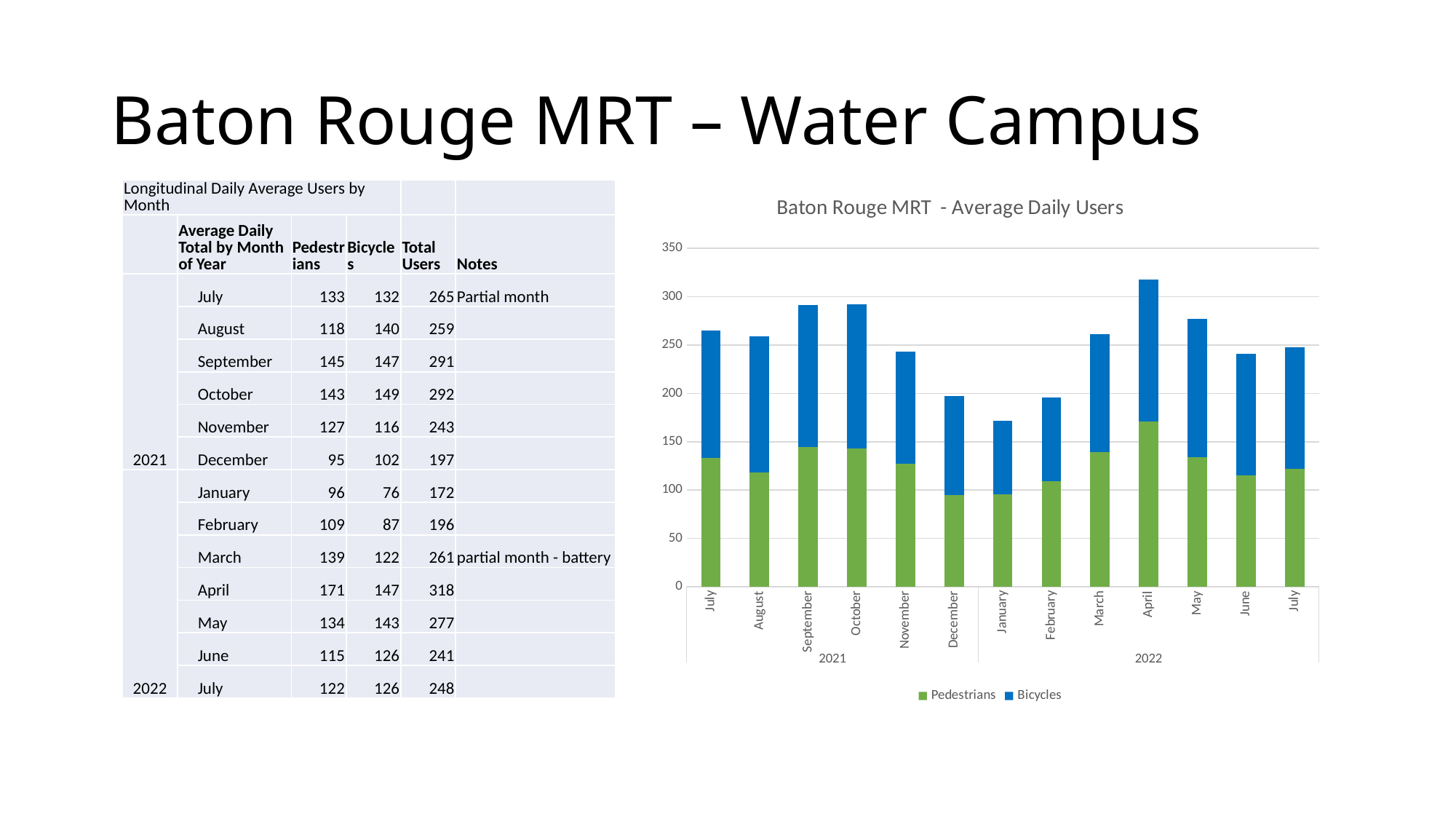
Do the total bars rise or fall from January 2022 to April 2022? rise How many series does the chart legend list? 2 What kind of chart is shown on the slide? Stacked bar chart Using the table values, what is the difference in Total Users between April 2022 and January 2022? 146 Which has a taller total bar, September 2021 or November 2021? September 2021 According to the table, what is the Total Users value for April 2022? 318 Is the total bar for April 2022 greater or less than 300? greater How many monthly bars are plotted in the chart? 13 What is the title of the chart? Baton Rouge MRT - Average Daily Users Which month has the highest total average daily users in the chart? April 2022 Is the total bar for January 2022 greater or less than 200? less Which month has the lowest total average daily users in the chart? January 2022